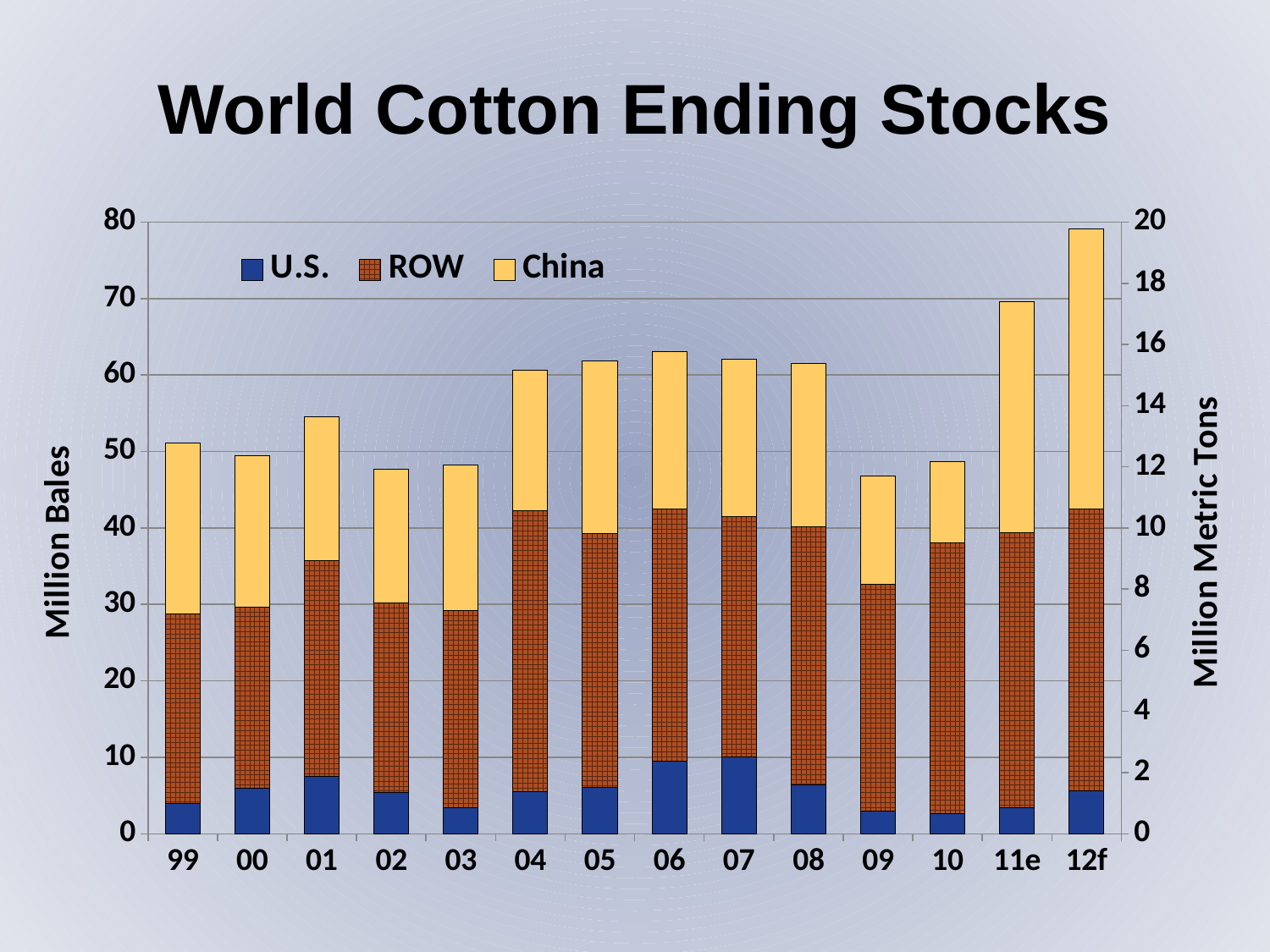
How many series does the legend list? 3 What is the label on the left vertical axis? Million Bales Do total ending stocks rise or fall from 09 to 12f? rise Is the total stacked bar for 99 greater or less than 60 million bales? less What kind of chart is shown on the slide? Stacked bar chart How many years (categories) are shown on the x axis? 14 Which has the larger total ending stocks, 01 or 02? 01 Is the U.S. segment for 06 greater or less than 5 million bales? greater Is the total stacked bar for 12f greater or less than 70 million bales? greater Which year has the highest total ending stocks? 12f Which has the larger total ending stocks, 11e or 12f? 12f